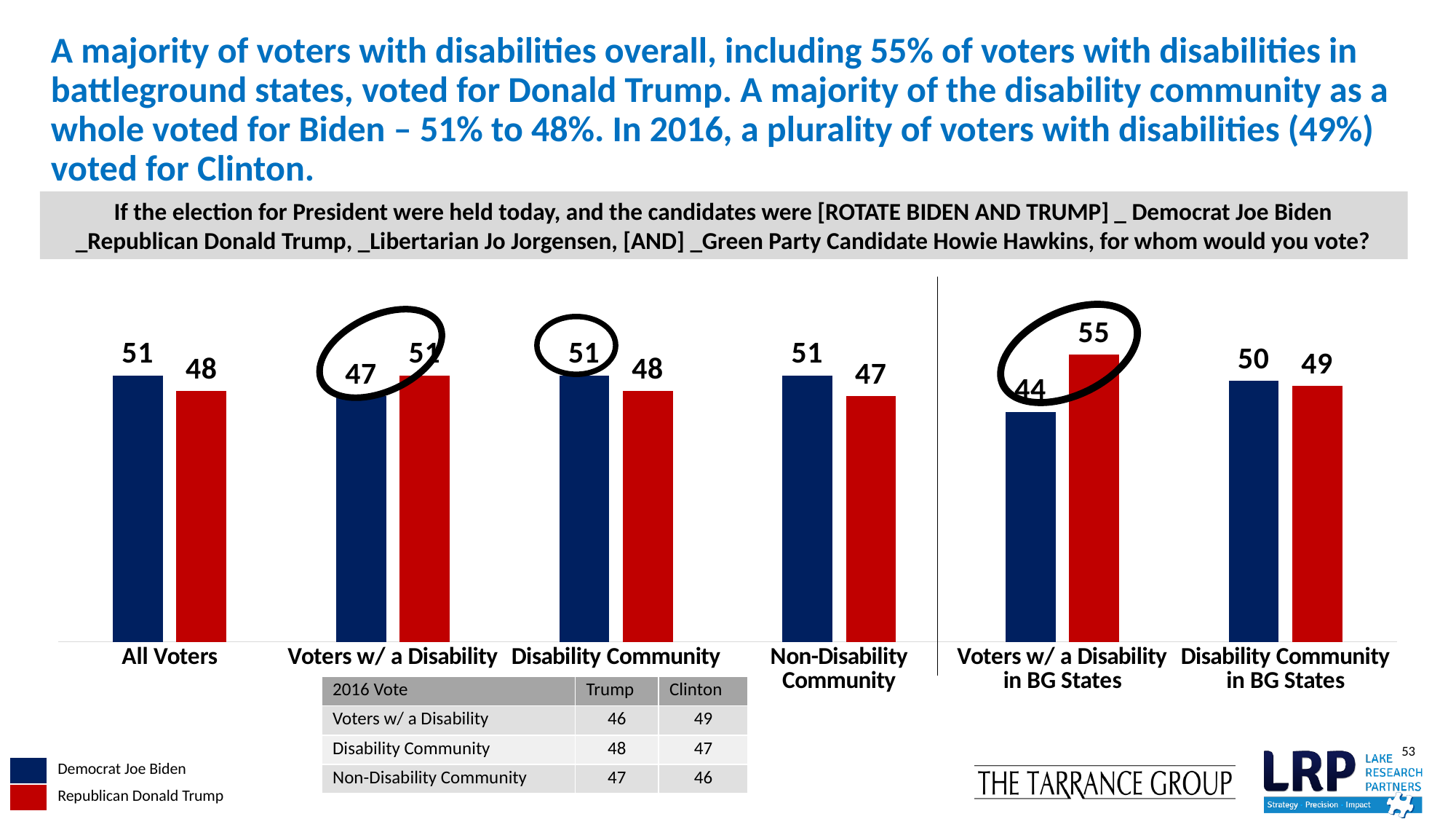
Which colour represents Republican Donald Trump in the chart? Red Which category has the lowest value for Democrat Joe Biden? Voters w/ a Disability in BG States Which category has the highest value for Republican Donald Trump? Voters w/ a Disability in BG States What is the value for Republican Donald Trump in the Non-Disability Community? 47 What is the value for Democrat Joe Biden among Voters w/ a Disability? 47 How many categories are shown on the x axis of the chart? 6 What is the value for Democrat Joe Biden among All Voters? 51 What kind of chart is shown on the slide? Bar chart How many series does the legend list? 2 What is the difference between the Trump and Biden values among Voters w/ a Disability in BG States? 11 What is the value for Republican Donald Trump among Voters w/ a Disability in BG States? 55 Among Voters w/ a Disability, which candidate has the larger value, Biden or Trump? Republican Donald Trump